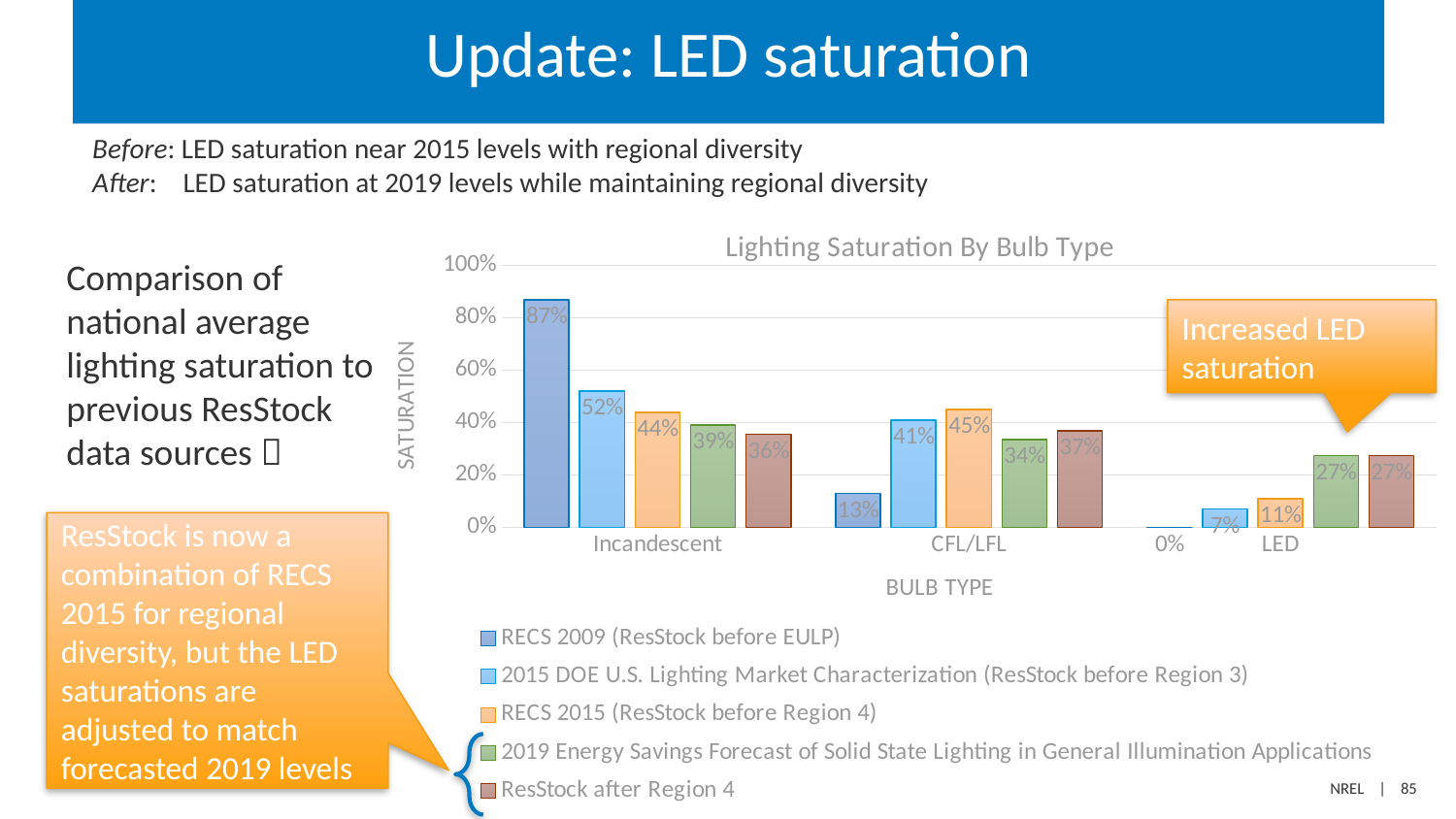
How many bulb type categories are shown on the x axis? 3 What is the difference between the Incandescent saturation for RECS 2009 (87%) and for ResStock after Region 4 (36%)? 51% How many series does the chart legend list? 5 What is the Incandescent saturation for RECS 2009 (ResStock before EULP)? 87% What is the title of the chart? Lighting Saturation By Bulb Type For CFL/LFL, which is larger: the RECS 2015 (ResStock before Region 4) value or the ResStock after Region 4 value? RECS 2015 (ResStock before Region 4) What is the LED saturation for ResStock after Region 4? 27% What type of chart is shown on the slide? bar chart Is the Incandescent saturation for RECS 2009 (ResStock before EULP) greater or less than 80%? greater Which bulb type has the lowest saturation in the 2015 DOE U.S. Lighting Market Characterization series? LED What is the CFL/LFL saturation for RECS 2015 (ResStock before Region 4)? 45% Which bulb type has the highest saturation in the RECS 2009 (ResStock before EULP) series? Incandescent